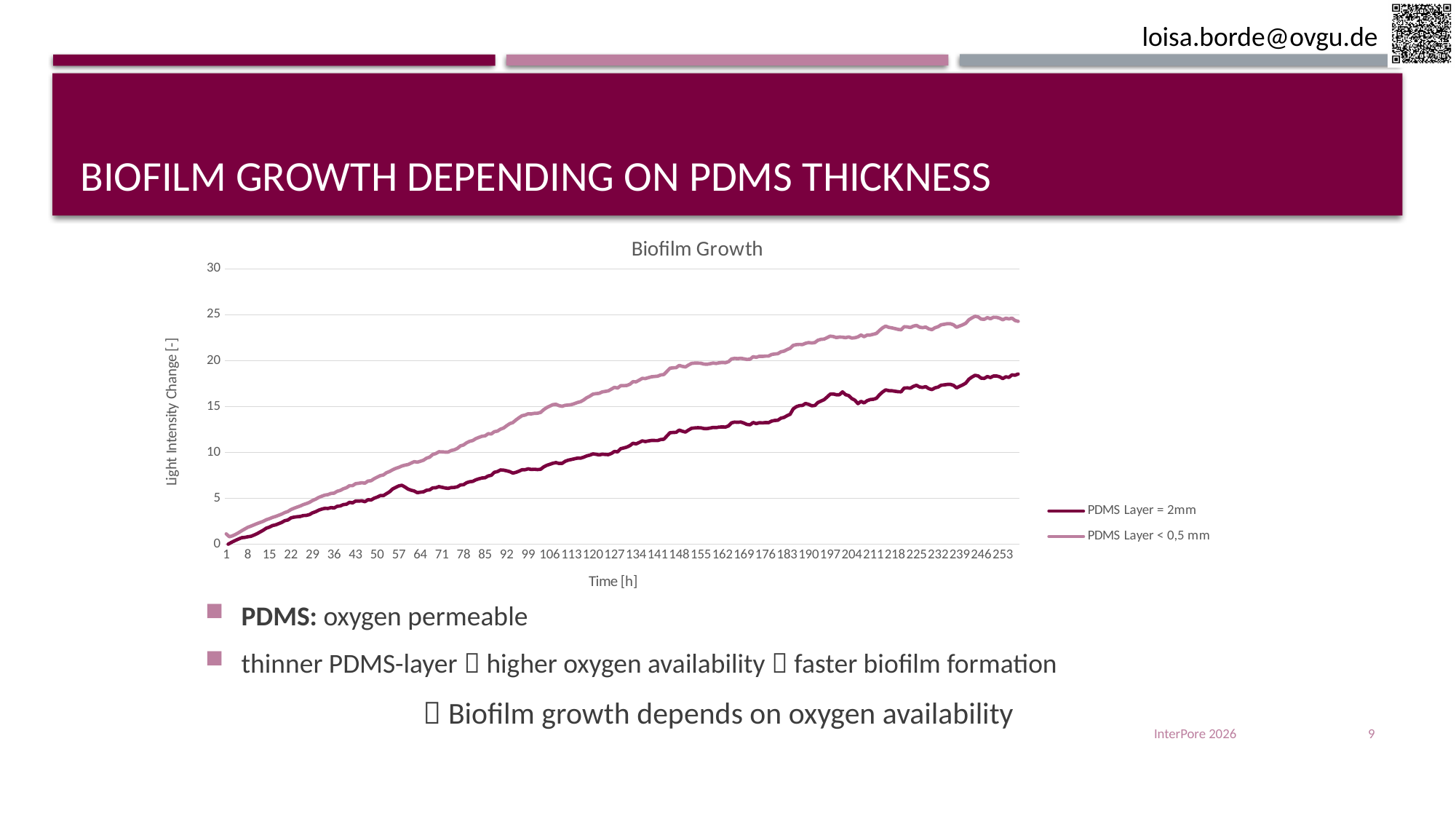
Is the value for PDMS Layer = 2mm at time 253 greater or less than 20? less Is the value for PDMS Layer < 0,5 mm at time 64 greater or less than 10? less What is the title of the chart? Biofilm Growth What kind of chart is shown on the slide? line chart Is the value for PDMS Layer < 0,5 mm at time 127 greater or less than 15? greater Which series reaches the higher value at the end of the time axis, PDMS Layer = 2mm or PDMS Layer < 0,5 mm? PDMS Layer < 0,5 mm Do the values for PDMS Layer < 0,5 mm rise or fall along the time axis? rise How many series does the legend of the Biofilm Growth chart list? 2 Do the values for PDMS Layer = 2mm rise or fall overall along the time axis? rise What is the label of the y axis of the chart? Light Intensity Change [-]